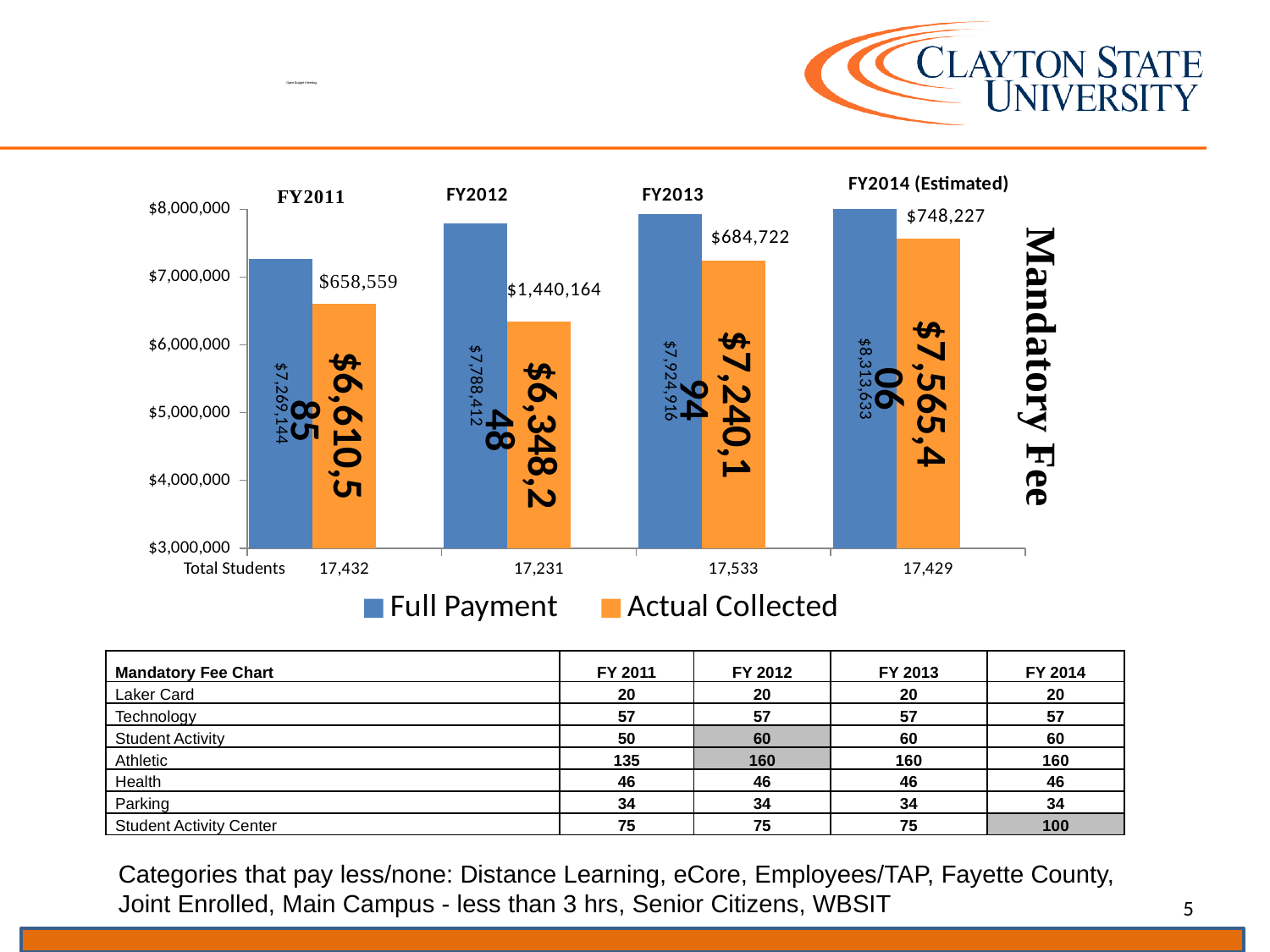
What are the two series named in the chart legend? Full Payment and Actual Collected What is the Full Payment value for FY2011? $7,269,144 Which fiscal year has the lowest Actual Collected value? FY2012 How many fiscal years are plotted on the chart? 4 What is the difference between Full Payment and Actual Collected in FY2012? $1,440,164 How many series does the chart legend list? 2 Which fiscal year has the highest Full Payment value? FY2014 (Estimated) What is the Full Payment value for FY2014 (Estimated)? $8,313,633 Does the Full Payment value rise or fall from FY2011 to FY2014 (Estimated)? rise What is the Actual Collected value for FY2013? $7,240,194 What type of chart is shown on the slide? bar chart Is the Actual Collected value for FY2011 greater or less than $7,000,000? less